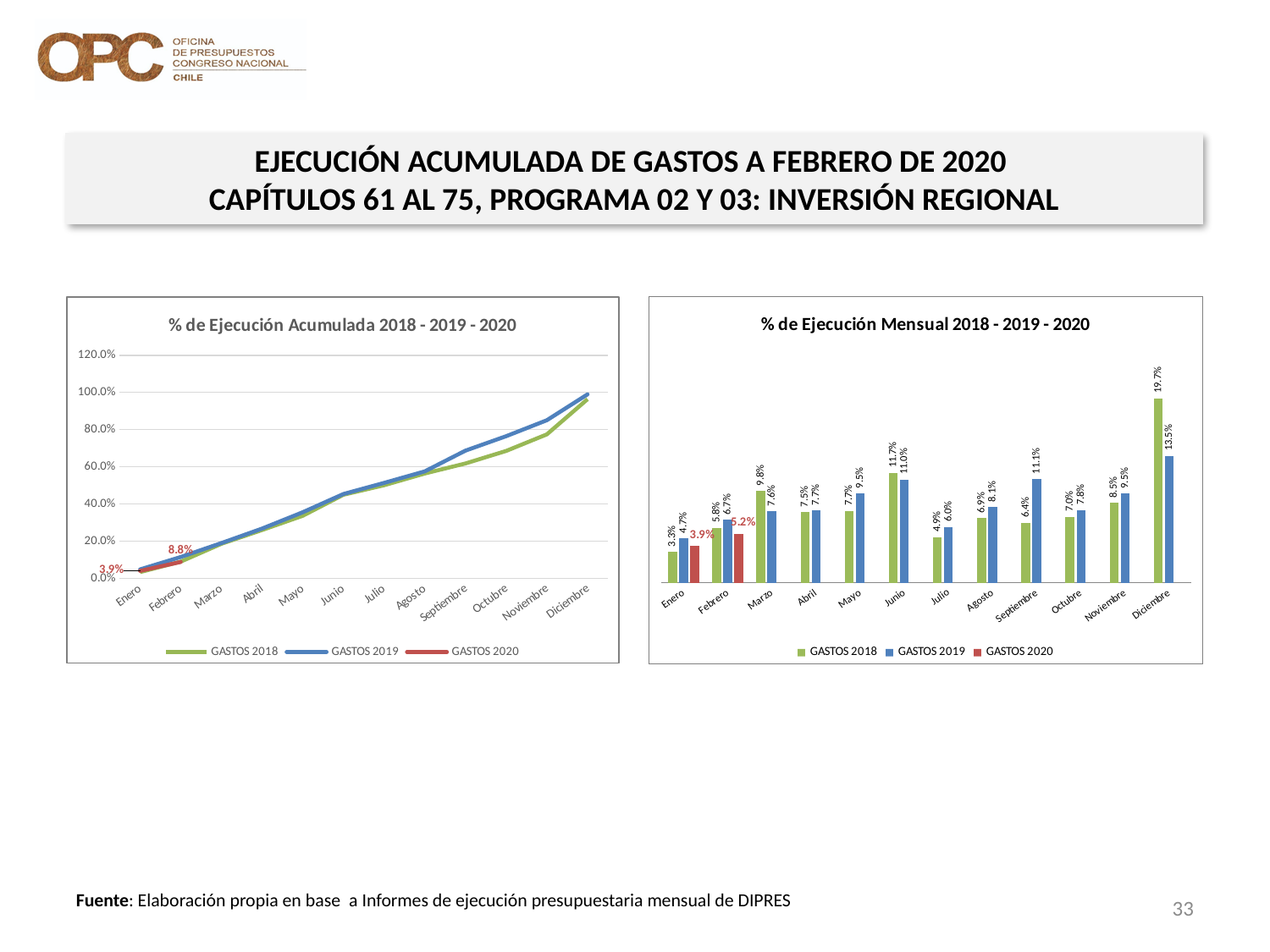
In the right chart '% de Ejecución Mensual 2018 - 2019 - 2020', how many series does the legend list? 3 In the right chart '% de Ejecución Mensual 2018 - 2019 - 2020', which is larger in Septiembre: GASTOS 2018 or GASTOS 2019? GASTOS 2019 In the left chart '% de Ejecución Acumulada 2018 - 2019 - 2020', what is the difference between the GASTOS 2020 values for Febrero and Enero? 4.9 percentage points In the left chart '% de Ejecución Acumulada 2018 - 2019 - 2020', what is the value for GASTOS 2020 in Febrero? 8.8% In the right chart '% de Ejecución Mensual 2018 - 2019 - 2020', which month has the lowest value for GASTOS 2018? Enero In the right chart '% de Ejecución Mensual 2018 - 2019 - 2020', which month has the highest value for GASTOS 2019? Diciembre In the left chart '% de Ejecución Acumulada 2018 - 2019 - 2020', how many months are shown on the x axis? 12 In the left chart '% de Ejecución Acumulada 2018 - 2019 - 2020', is the value for GASTOS 2019 in Diciembre greater or less than 80.0%? greater What kind of chart is the left chart titled '% de Ejecución Acumulada 2018 - 2019 - 2020'? Line chart In the right chart '% de Ejecución Mensual 2018 - 2019 - 2020', what is the difference between GASTOS 2018 and GASTOS 2019 in Diciembre? 6.2 percentage points What kind of chart is the right chart titled '% de Ejecución Mensual 2018 - 2019 - 2020'? Bar chart In the right chart '% de Ejecución Mensual 2018 - 2019 - 2020', what is the value for GASTOS 2018 in Diciembre? 19.7%